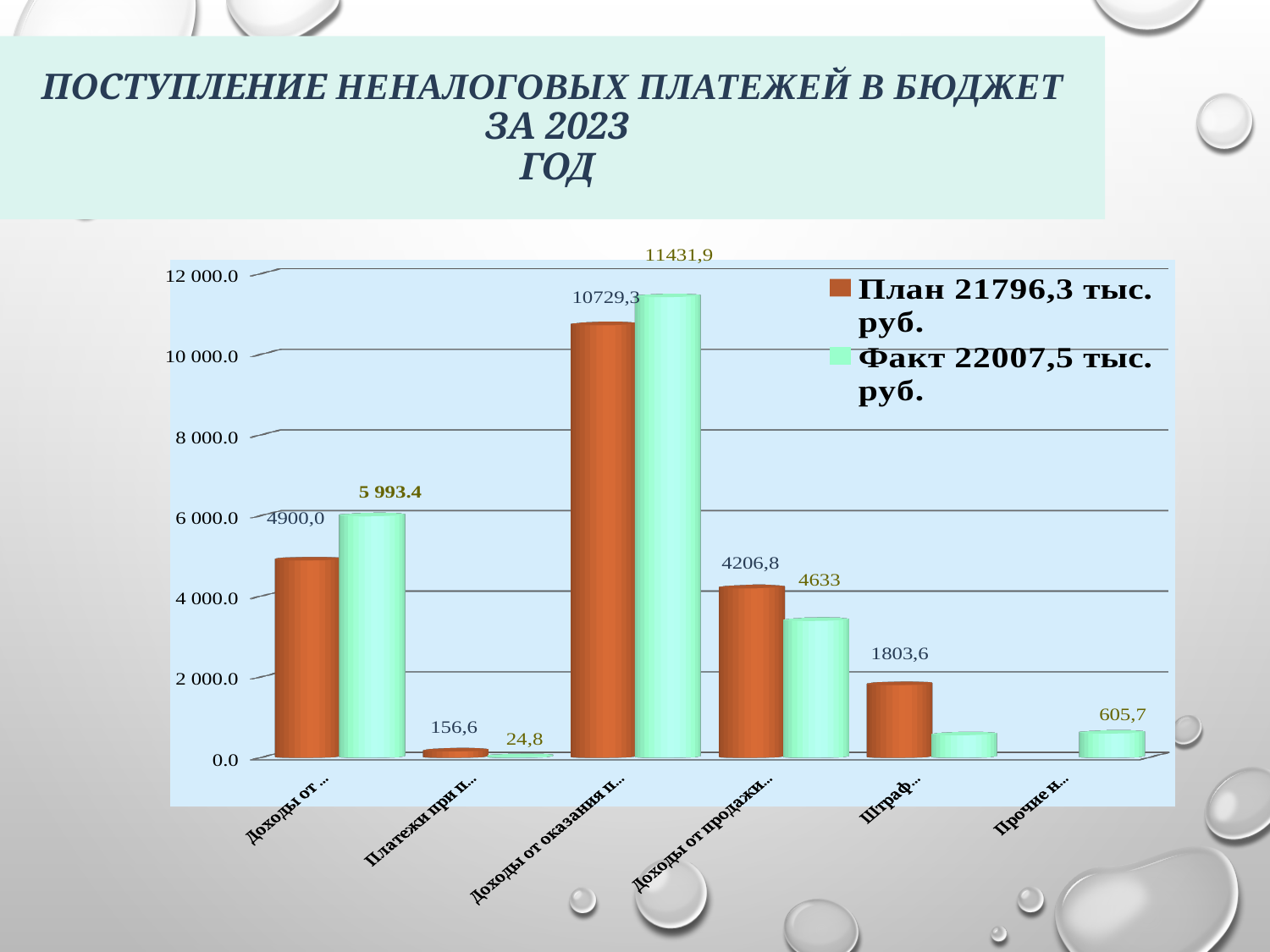
What is the Факт value for the third category (Доходы от оказания п...)? 11431,9 For the first category (Доходы от ...), which is larger, the План value or the Факт value? Факт By how much does the Факт value exceed the План value for the third category (Доходы от оказания п...)? 702,6 Which category has the highest Факт value? Доходы от оказания п... (third category) Is the Факт value for the category Штраф... greater or less than 2 000.0? less What is the План value for the category Штраф...? 1803,6 What kind of chart is shown on the slide? bar chart What is the План value for the third category (Доходы от оказания п...)? 10729,3 How many series does the legend list? 2 How many categories are shown along the x axis? 6 What is the first legend entry of the chart? План 21796,3 тыс. руб. What is the Факт value for the last category (Прочие н...)? 605,7